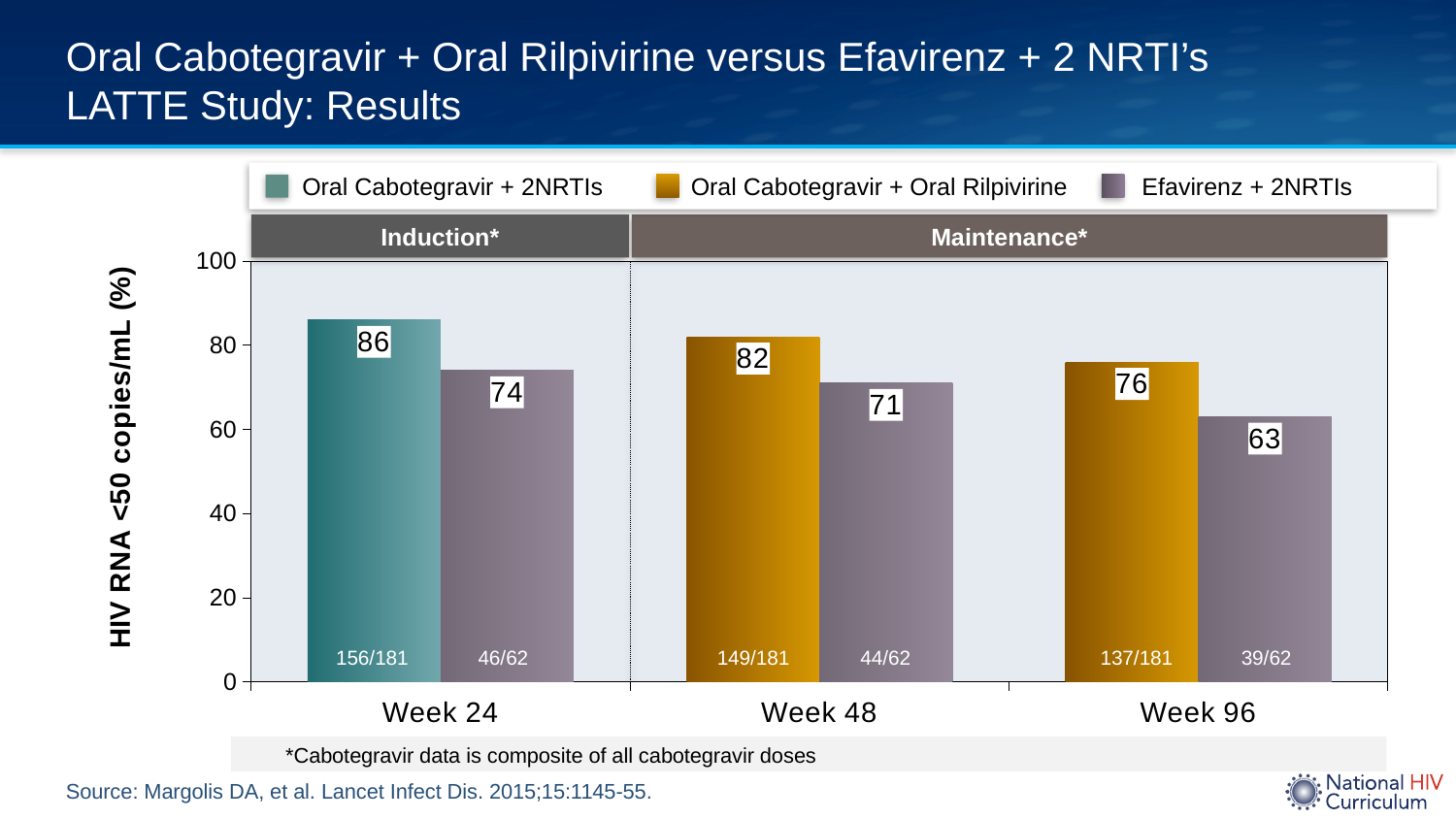
Do the Efavirenz + 2NRTIs values rise or fall from Week 24 to Week 96? Fall Which bar on the chart has the lowest value? Efavirenz + 2NRTIs at Week 96 What is the value for Efavirenz + 2NRTIs at Week 96? 63 How many series does the legend list? 3 Which bar on the chart has the highest value? Oral Cabotegravir + 2NRTIs at Week 24 What is the difference between the Oral Cabotegravir + Oral Rilpivirine and Efavirenz + 2NRTIs values at Week 96? 13 What kind of chart is shown on the slide? Bar chart How many week time points are shown on the x axis? 3 What fraction is printed on the Efavirenz + 2NRTIs bar at Week 48? 44/62 What is the value for Oral Cabotegravir + 2NRTIs at Week 24? 86 What is the value for Oral Cabotegravir + Oral Rilpivirine at Week 48? 82 At Week 24, which is larger: Oral Cabotegravir + 2NRTIs or Efavirenz + 2NRTIs? Oral Cabotegravir + 2NRTIs